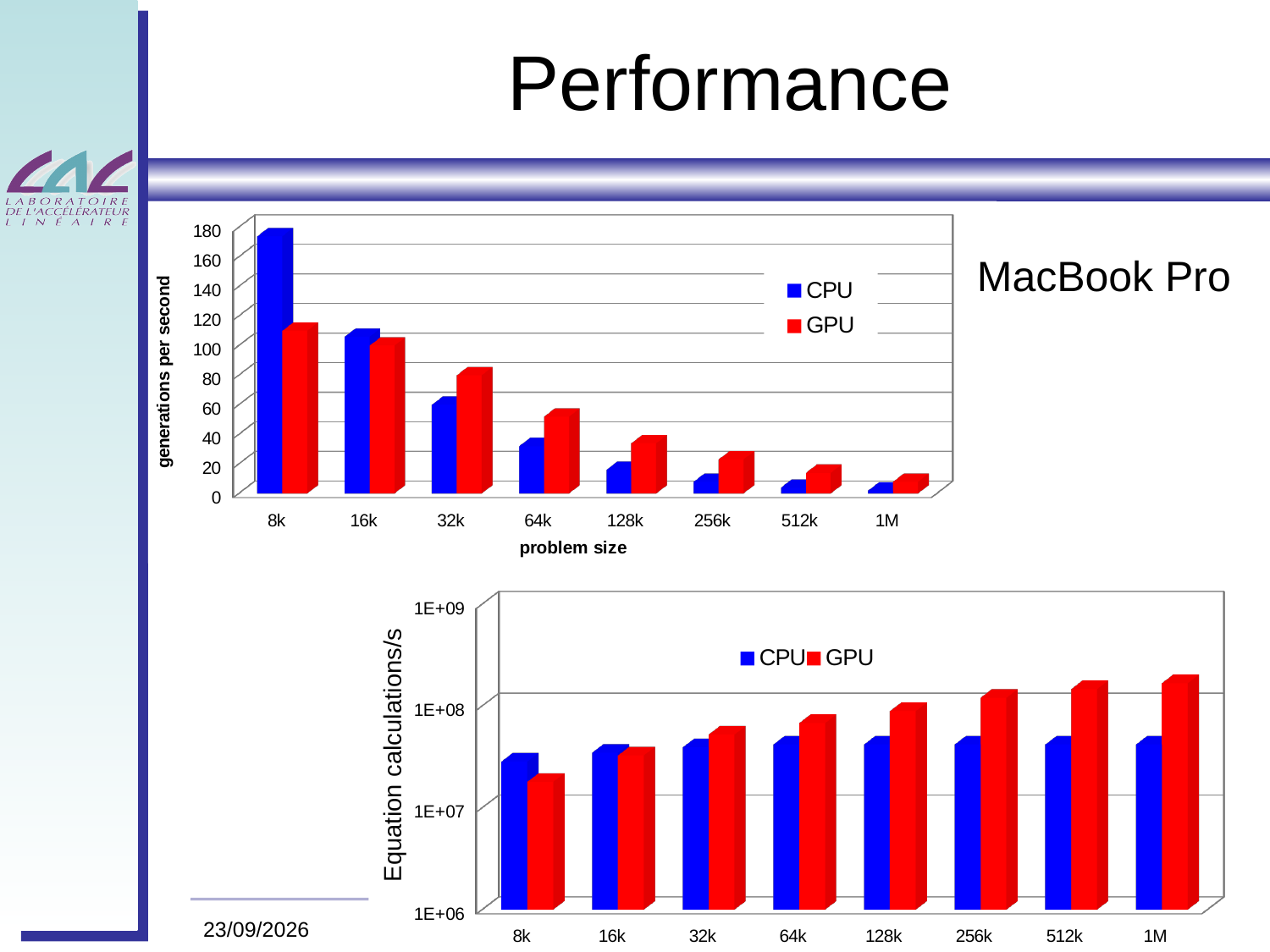
In the bottom chart (Equation calculations/s), is the GPU value for 1M greater or less than 1E+08? greater What kind of chart is the top chart (generations per second)? bar chart In the top chart (generations per second), how many problem sizes are shown on the x axis? 8 In the top chart (generations per second), how many series does the legend list? 2 In the top chart, what is the x-axis title? problem size In the bottom chart (Equation calculations/s), do the GPU values rise or fall as problem size increases along the x axis? rise In the top chart (generations per second), is the CPU value for 8k greater or less than 160? greater In the top chart (generations per second), do the CPU values rise or fall as problem size increases along the x axis? fall In the bottom chart (Equation calculations/s), at problem size 8k, which is larger, CPU or GPU? CPU In the top chart (generations per second), which problem size has the highest CPU value? 8k In the top chart (generations per second), at problem size 32k, which is larger, CPU or GPU? GPU In the bottom chart, what is the y-axis label? Equation calculations/s